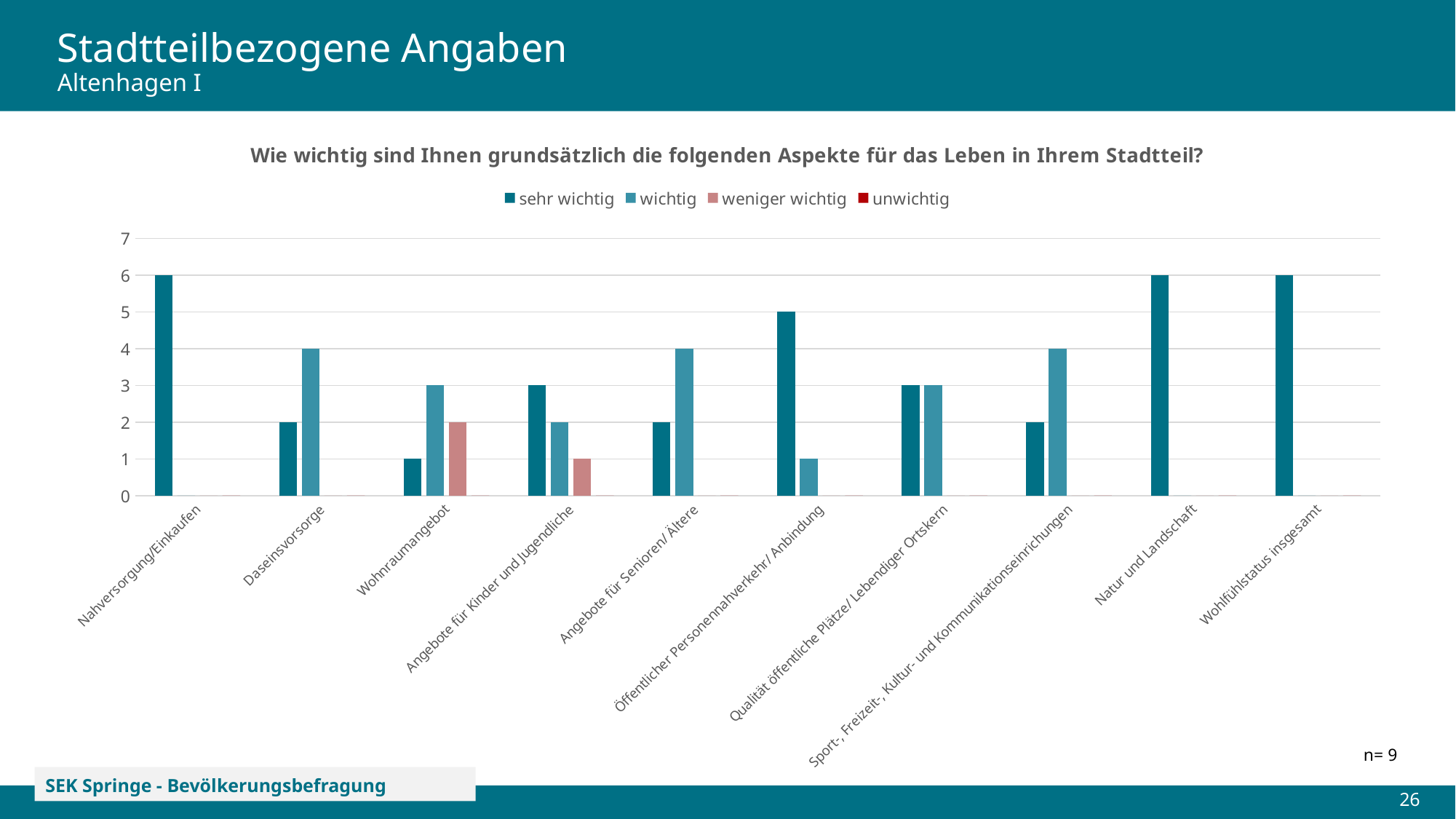
How many categories are shown on the x axis? 10 Which is larger: the 'sehr wichtig' value for Öffentlicher Personennahverkehr/ Anbindung or for Daseinsvorsorge? Öffentlicher Personennahverkehr/ Anbindung Is the 'sehr wichtig' value for Natur und Landschaft greater or less than 5? greater Which legend entry is shown in dark red? unwichtig What is the value for 'sehr wichtig' for Öffentlicher Personennahverkehr/ Anbindung? 5 How many series does the legend list? 4 What is the value for 'weniger wichtig' for Wohnraumangebot? 2 What is the value for 'wichtig' for Daseinsvorsorge? 4 Which category has the lowest value for 'sehr wichtig'? Wohnraumangebot What is the difference between the 'wichtig' and 'sehr wichtig' values for Daseinsvorsorge? 2 What is the value for 'sehr wichtig' for Nahversorgung/Einkaufen? 6 What kind of chart is shown on the slide? Bar chart